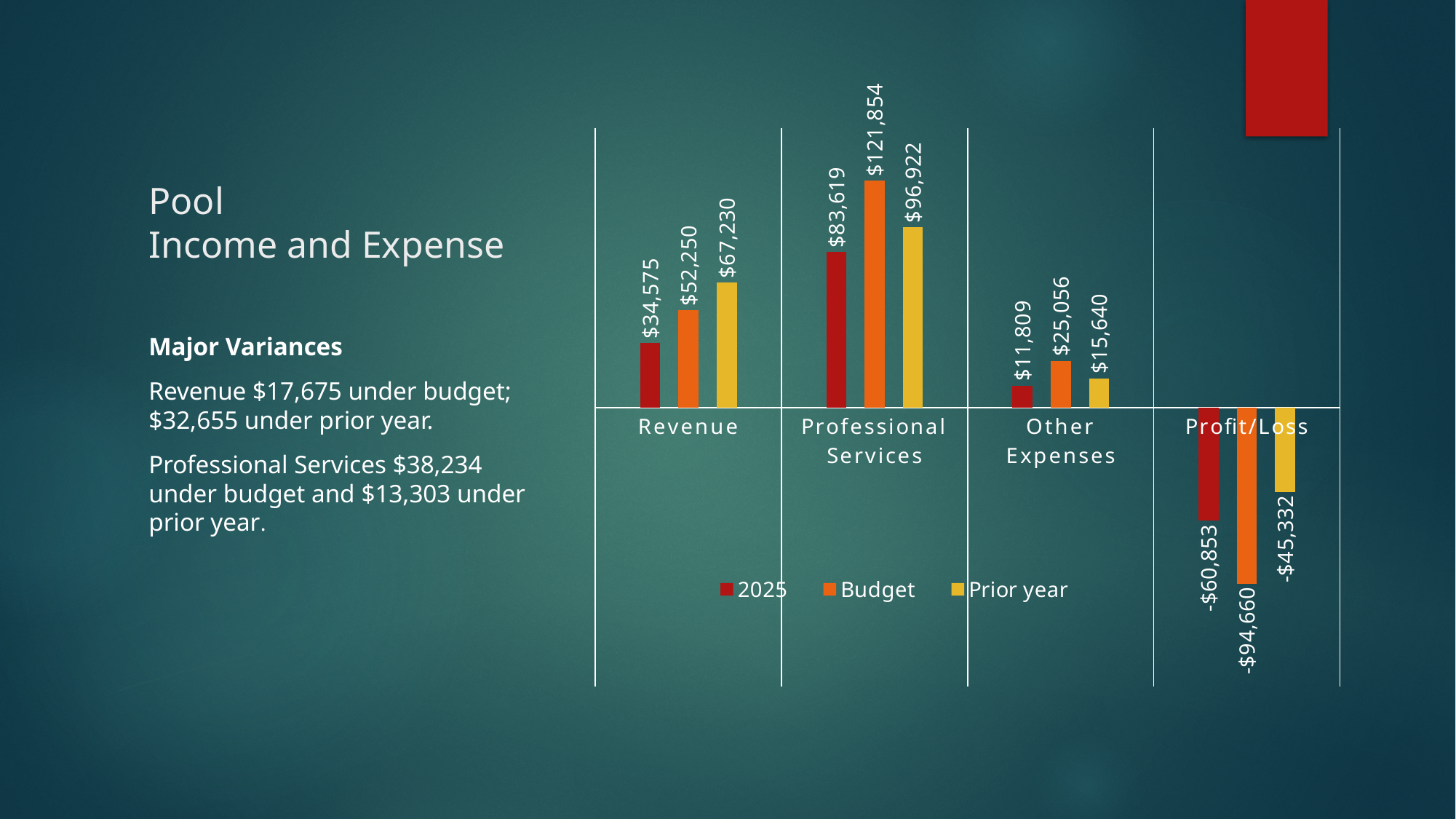
Which is larger for Other Expenses, the 2025 value or the Budget value? Budget What is the Budget value for Professional Services? $121,854 What is the difference between the Budget and 2025 values for Revenue? $17,675 Which series is shown in dark red in the legend? 2025 What is the Prior year value for Other Expenses? $15,640 How many categories are shown on the x axis? 4 Which category has the lowest 2025 value? Profit/Loss Which category has the highest Budget value? Professional Services What is the 2025 value for Revenue? $34,575 How many series does the legend list? 3 What is the Budget value for Profit/Loss? -$94,660 What kind of chart is shown on the slide? Bar chart